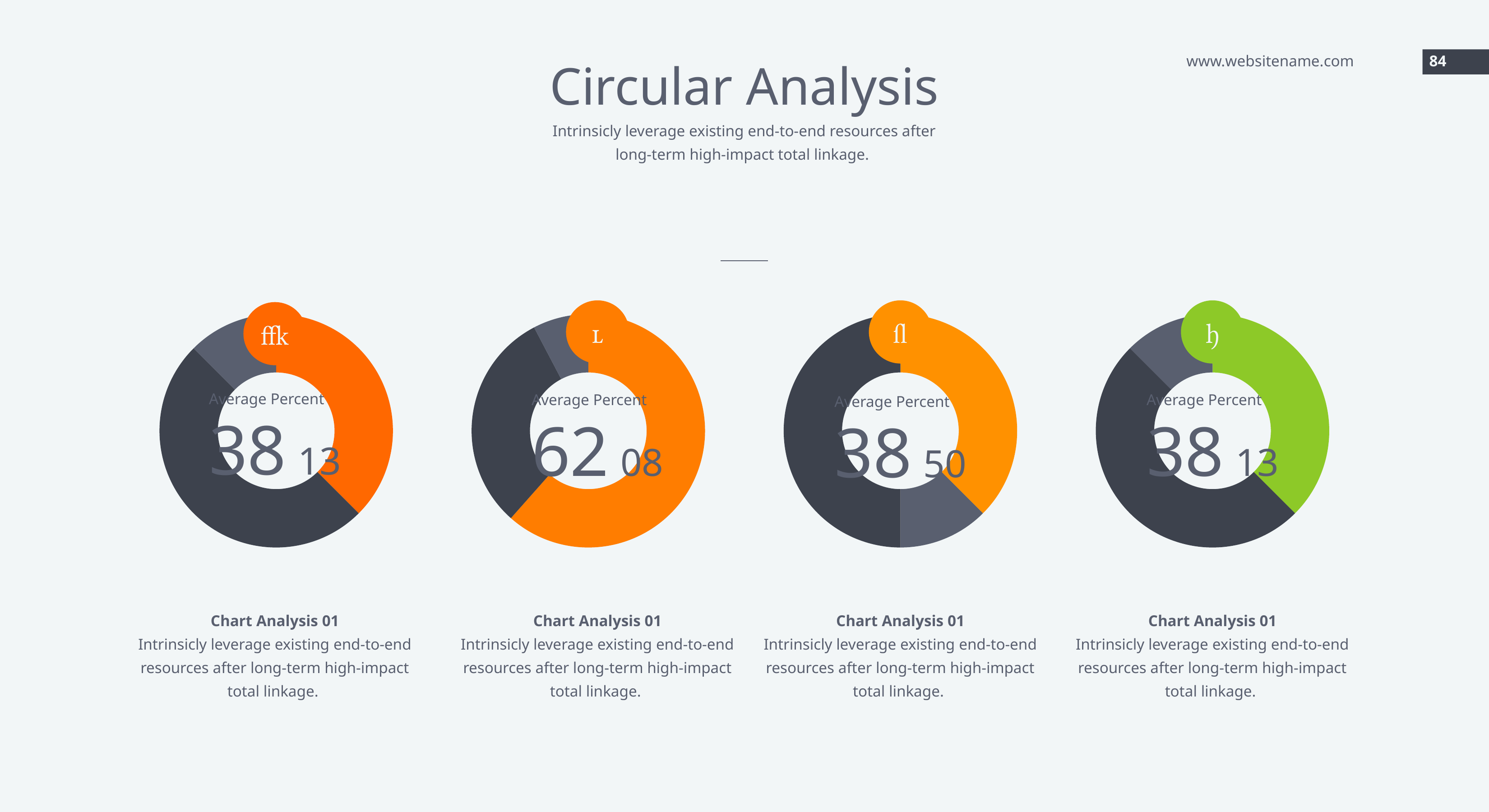
What smaller number appears next to the large number in the centre of the fourth (rightmost) chart? 13 What kind of chart is used for each of the four charts on the slide? Donut (pie) chart What large number is shown in the centre of the second chart from the left? 62 Which of the four charts has the largest coloured (non-grey) segment? The second chart (62) How many segments does each donut chart contain? 3 What large number is shown in the centre of the first (leftmost) chart? 38 What smaller number appears next to the large number in the centre of the second chart? 08 What smaller number appears next to the large number in the centre of the third chart? 50 Is the coloured segment of the second chart larger or smaller than the coloured segment of the first chart? Larger What label appears above the number in the centre of each chart? Average Percent How many charts are shown on the slide? 4 What colour is the highlighted segment of the fourth (rightmost) chart? Green